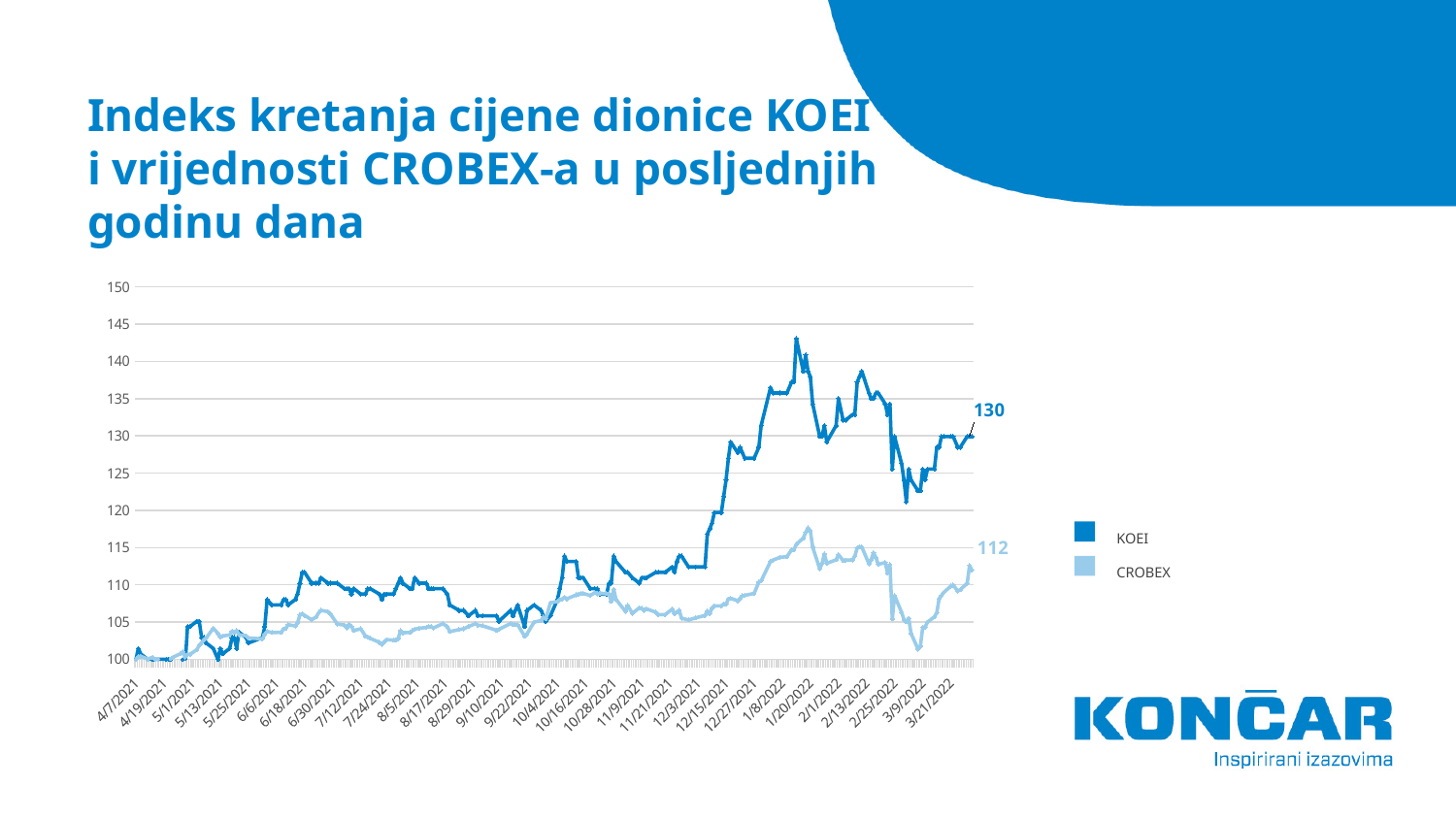
Is the peak value of the KOEI series greater or less than 140? greater Is the peak value of the CROBEX series greater or less than 120? less What is the difference between the final labelled values of KOEI and CROBEX? 18 Does the KOEI series overall rise or fall from the start of the period to the end? rise Which series is drawn in the lighter blue colour? CROBEX How many series does the legend list? 2 What is the highest value shown on the vertical axis? 150 What is the final labelled value of the CROBEX series? 112 What kind of chart is shown on the slide? Line chart Which series reaches the highest peak on the chart? KOEI Which series ends at a higher value, KOEI or CROBEX? KOEI What is the final labelled value of the KOEI series? 130